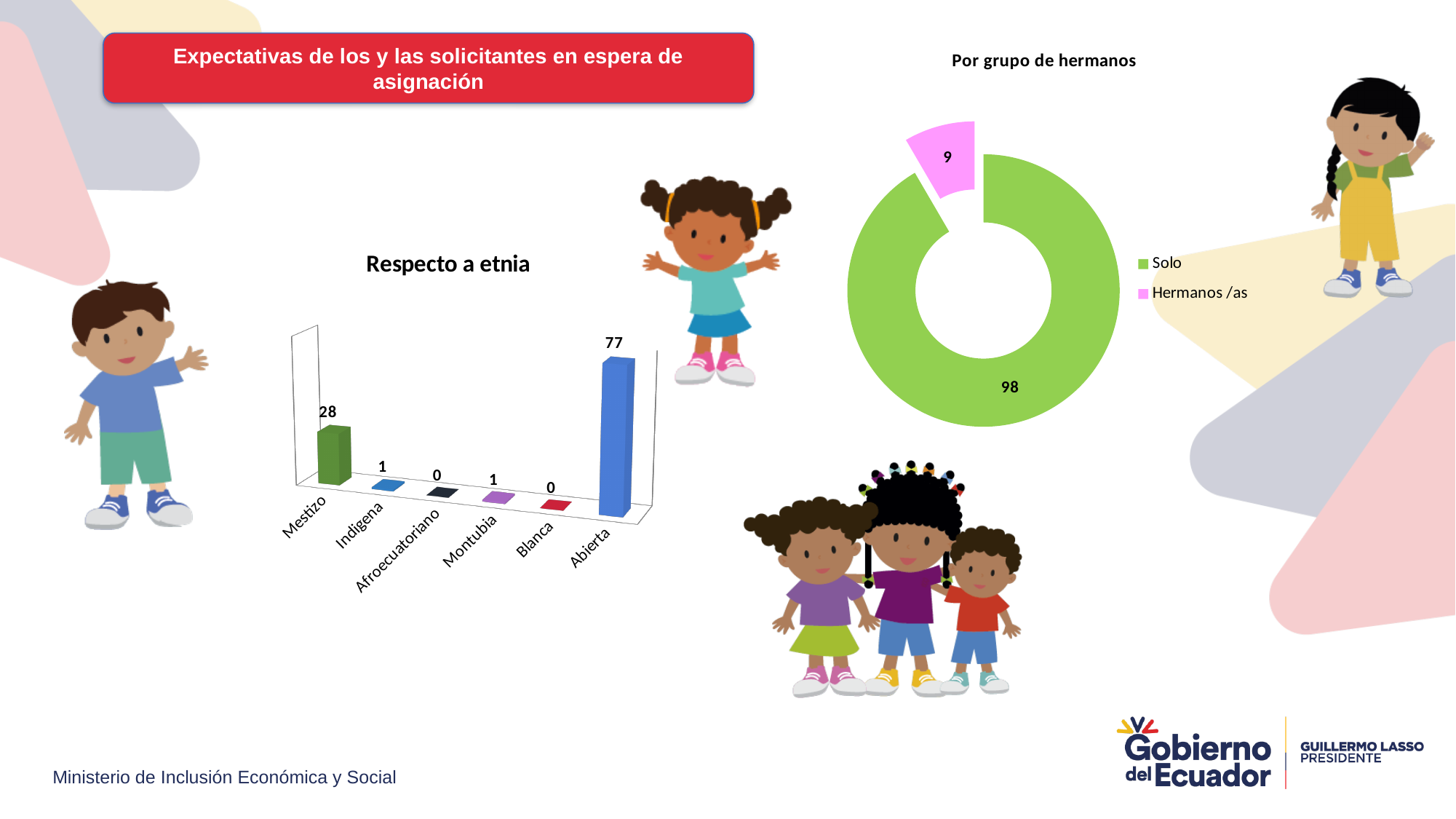
In the 'Respecto a etnia' chart, how many categories are shown on the x axis? 6 In the 'Respecto a etnia' chart, what is the value for Abierta? 77 In the 'Por grupo de hermanos' chart, what is the total of the two segments? 107 In the 'Por grupo de hermanos' chart, what is the value for Hermanos /as? 9 In the 'Por grupo de hermanos' chart, which segment is larger, Solo or Hermanos /as? Solo In the 'Respecto a etnia' chart, which categories have a value of 0? Afroecuatoriano and Blanca In the 'Respecto a etnia' chart, what is the value for Mestizo? 28 In the 'Por grupo de hermanos' chart, what is the value for Solo? 98 In the 'Respecto a etnia' chart, what is the difference between the values for Abierta and Mestizo? 49 In the 'Por grupo de hermanos' chart, how many entries does the legend list? 2 What kind of chart is 'Respecto a etnia'? Bar chart In the 'Respecto a etnia' chart, which category has the highest value? Abierta